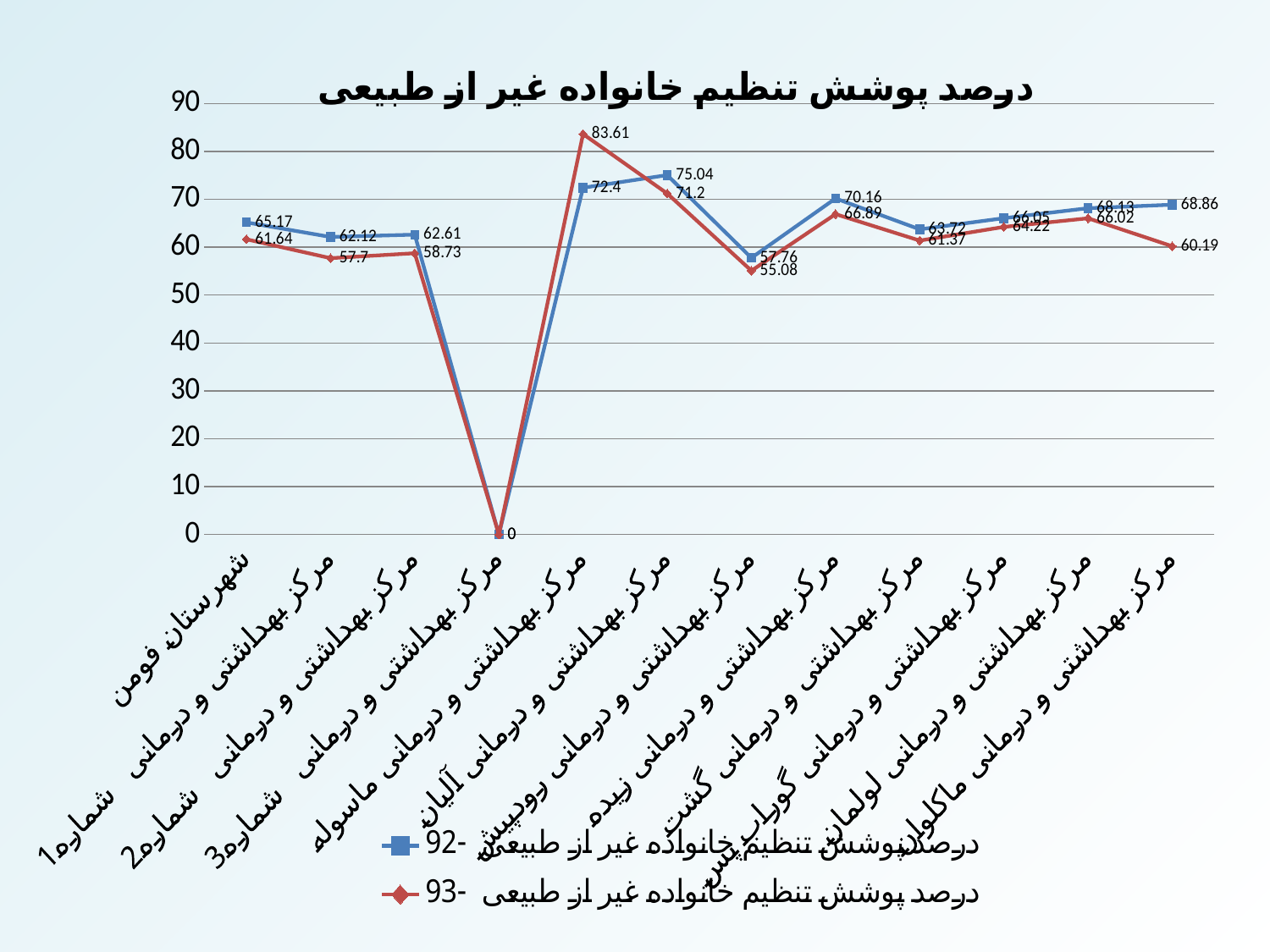
What is the value for مرکز بهداشتی و درمانی ماکلوان in the 93 series? 60.19 Which category has the highest value in the 92 series? مرکز بهداشتی و درمانی آلیان Which category has the lowest value in the 92 series? مرکز بهداشتی و درمانی شماره3 Is the 93 value for مرکز بهداشتی و درمانی ماسوله greater or less than 80? greater What is the difference between the 92 and 93 values for مرکز بهداشتی و درمانی ماکلوان? 8.67 How many categories are shown on the x axis? 12 What kind of chart is shown on the slide? line chart How many series does the legend list? 2 What is the value for شهرستان فومن in the 92 series? 65.17 What is the value for مرکز بهداشتی و درمانی ماسوله in the 93 series? 83.61 For مرکز بهداشتی و درمانی آلیان, which series has the larger value, 92 or 93? 92 Which category has the highest value in the 93 series? مرکز بهداشتی و درمانی ماسوله